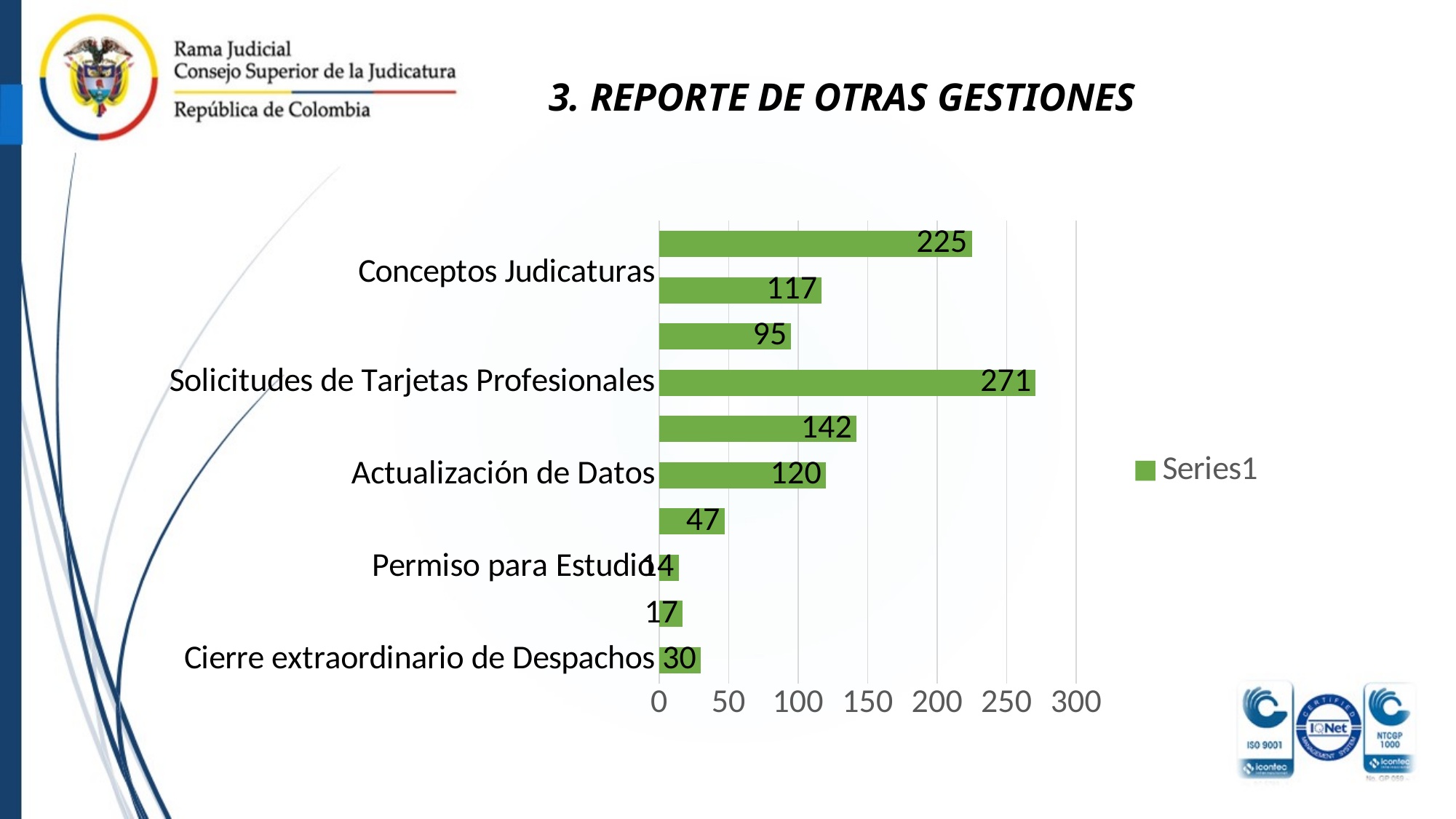
What is the value for Solicitudes de Tarjetas Profesionales? 271 What is the value for Actualización de Datos? 120 Which category has the lowest value? Permiso para Estudio What is the name of the series shown in the legend? Series1 Which is larger, the value for Cierre extraordinario de Despachos or the value for Permiso para Estudio? Cierre extraordinario de Despachos What is the value for Cierre extraordinario de Despachos? 30 How many bars are plotted in the chart? 10 What is the value for Permiso para Estudio? 14 What is the difference between the values for Solicitudes de Tarjetas Profesionales and Actualización de Datos? 151 Which category has the highest value? Solicitudes de Tarjetas Profesionales Is the value for Actualización de Datos greater or less than 100? greater What type of chart is shown on the slide? bar chart